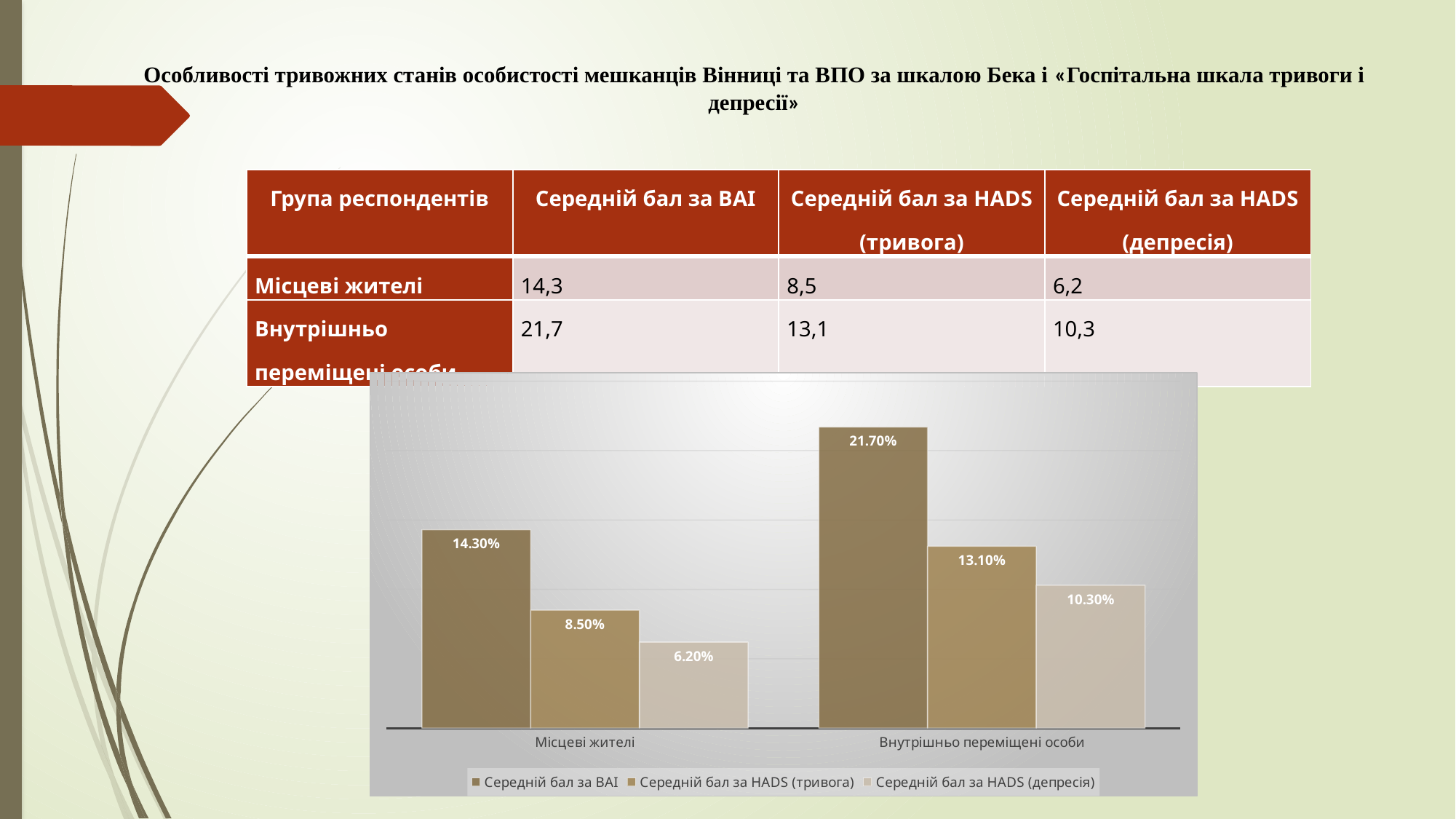
What is the value of Середній бал за HADS (депресія) for Внутрішньо переміщені особи in the chart? 10.30% Which bar in the chart has the highest value? Середній бал за BAI for Внутрішньо переміщені особи What is the value of Середній бал за HADS (тривога) for Внутрішньо переміщені особи in the chart? 13.10% What is the value of Середній бал за HADS (депресія) for Місцеві жителі in the chart? 6.20% Which category is shown on the left of the chart's x axis? Місцеві жителі How many categories are shown on the x axis of the chart? 2 Which group has the larger Середній бал за HADS (тривога) value in the chart, Місцеві жителі or Внутрішньо переміщені особи? Внутрішньо переміщені особи What is the value of Середній бал за BAI for Місцеві жителі in the chart? 14.30% How many series does the chart legend list? 3 What is the difference between the Середній бал за BAI values for Внутрішньо переміщені особи and Місцеві жителі in the chart? 7.40% Which bar in the chart has the lowest value? Середній бал за HADS (депресія) for Місцеві жителі What type of chart is shown on the slide? bar chart